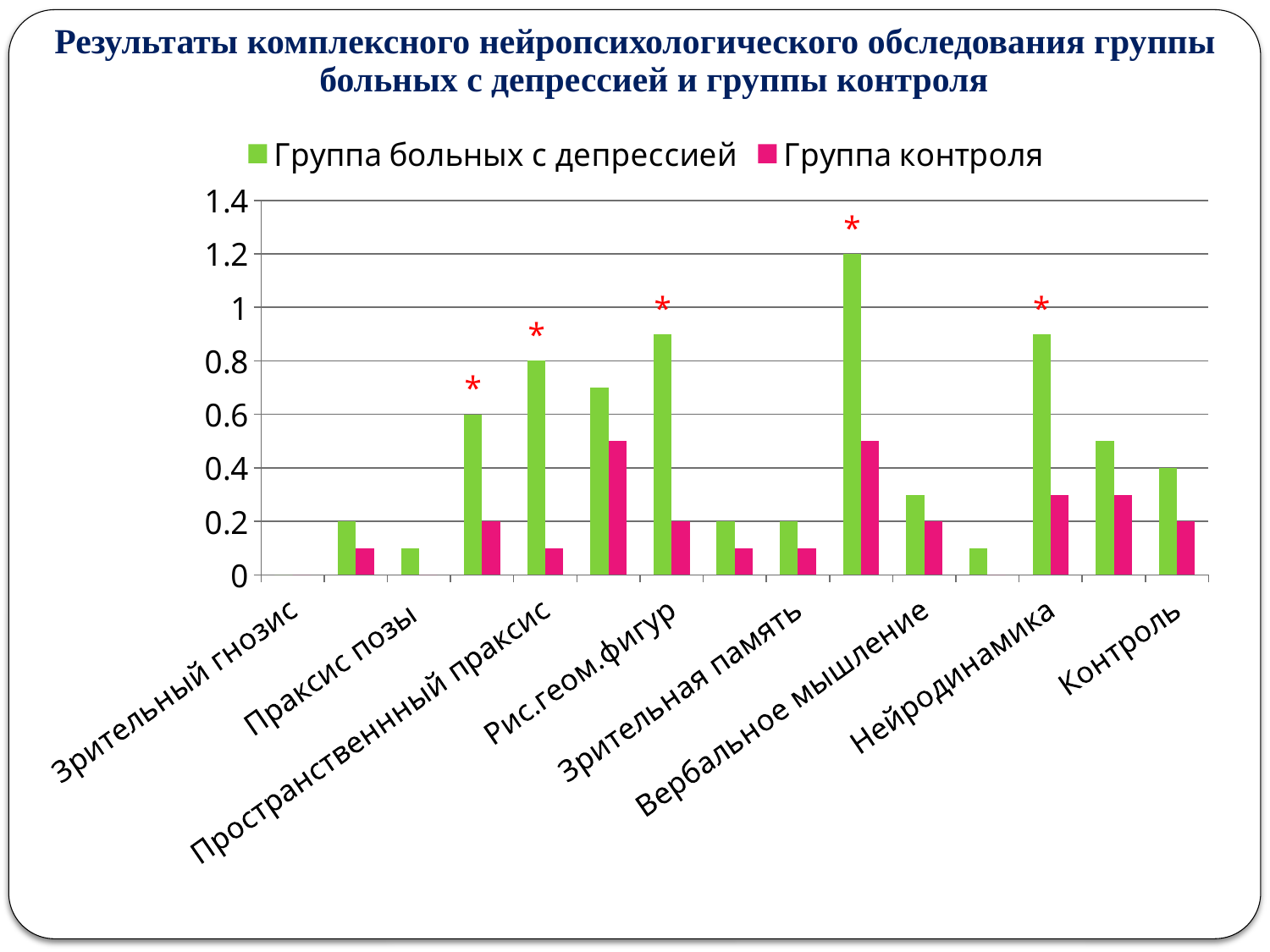
How many series does the legend list? 2 What is the highest value reached by any bar of the Группа больных с депрессией series? 1.2 What is the value for Группа больных с депрессией in the category Пространственнный праксис? 0.8 Is the value for Группа контроля in Пространственнный праксис greater or less than 0.2? less What kind of chart is shown on the slide? Bar chart What are the two series named in the legend? Группа больных с депрессией and Группа контроля Which colour represents Группа контроля? Pink In the category Нейродинамика, which series has the larger value, Группа больных с депрессией or Группа контроля? Группа больных с депрессией Is the value for Группа больных с депрессией in Нейродинамика greater or less than 0.8? greater What is the value for Группа контроля in the category Рис.геом.фигур? 0.2 What is the value for Группа больных с депрессией in the category Контроль? 0.4 What is the value for Группа контроля in the category Контроль? 0.2